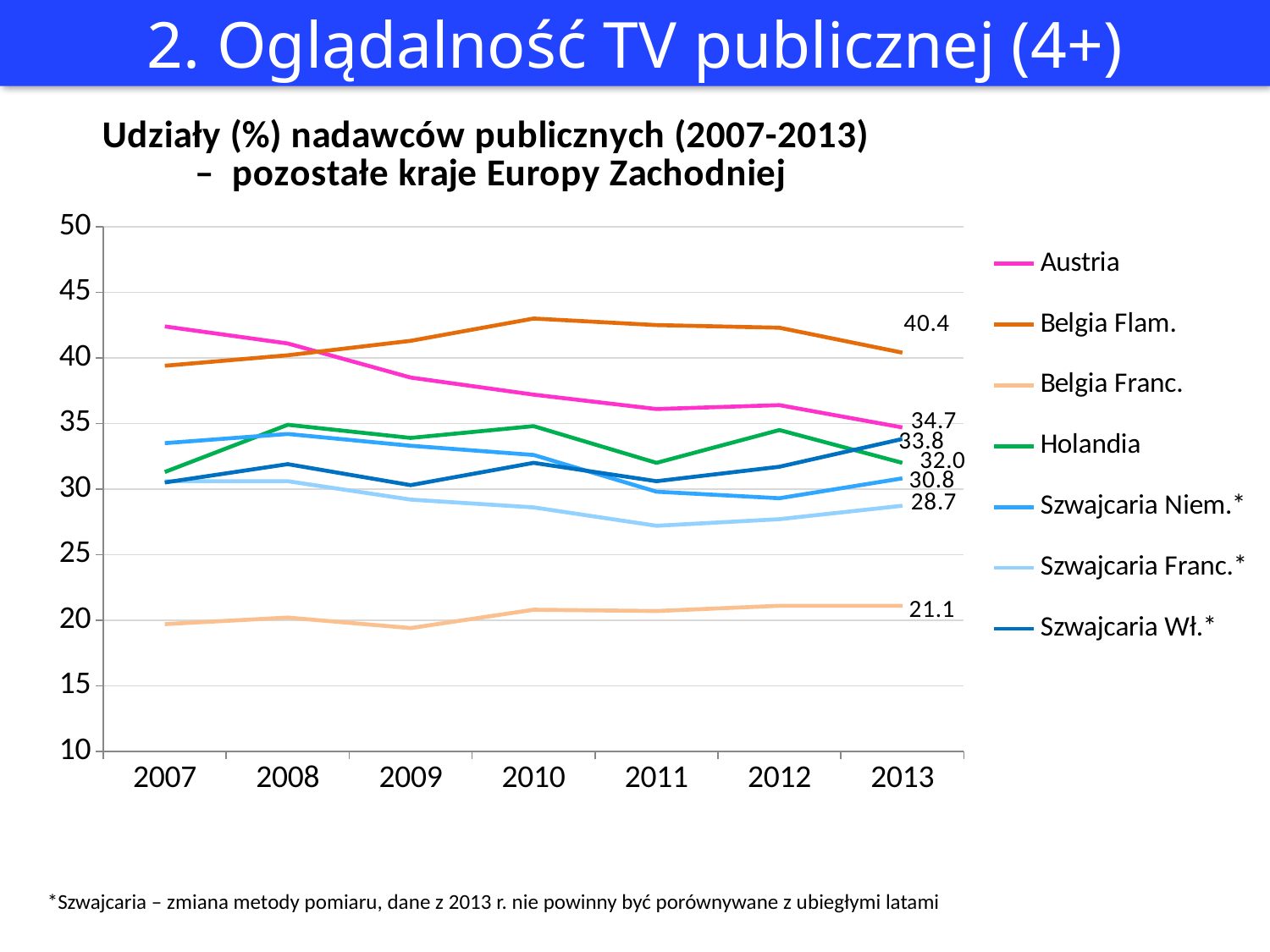
How many series does the legend list? 7 What is the value for Belgia Flam. in 2013? 40.4 What kind of chart is shown on the slide? Line chart What is the value for Austria in 2013? 34.7 Which series has the lowest value in 2013? Belgia Franc. How many years are shown on the x axis? 7 Is the value for Austria in 2007 greater or less than 40? greater In 2013, which is larger: Szwajcaria Niem.* or Szwajcaria Franc.*? Szwajcaria Niem.* What is the value for Holandia in 2013? 32.0 Which series has the highest value in 2013? Belgia Flam. What is the value for Belgia Franc. in 2013? 21.1 What is the difference between the 2013 values for Belgia Flam. and Austria? 5.7